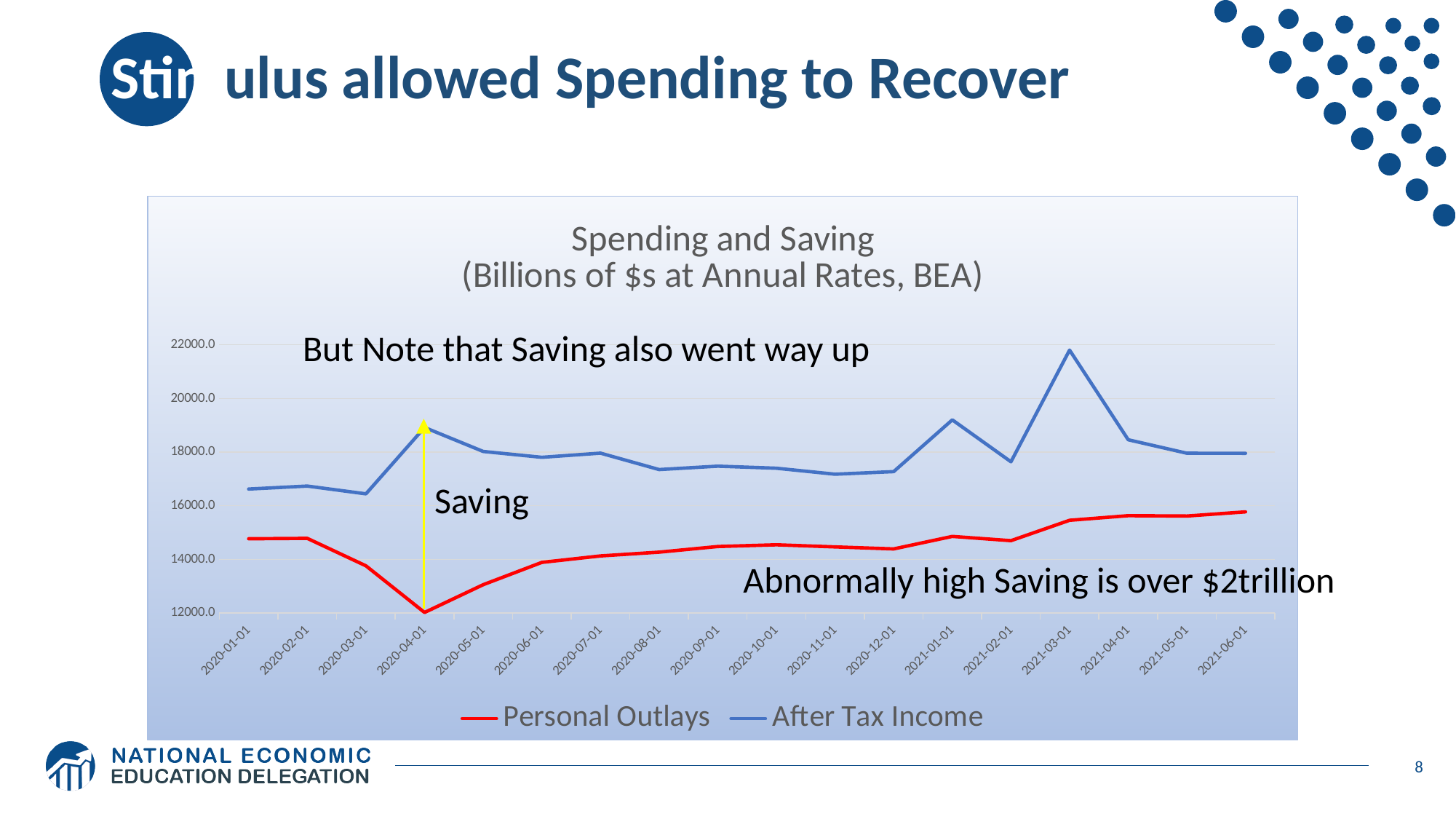
At 2020-04-01, which is larger: After Tax Income or Personal Outlays? After Tax Income Is the value for Personal Outlays at 2021-06-01 greater or less than 14000.0? greater How many dates are plotted along the x axis? 18 Is the value for Personal Outlays at 2020-04-01 greater or less than 14000.0? less How many series does the legend list? 2 Is the value for After Tax Income at 2020-01-01 greater or less than 18000.0? less At which date is Personal Outlays at its lowest? 2020-04-01 Does Personal Outlays rise or fall from 2020-04-01 to 2021-06-01? rise What kind of chart is shown on the slide? line chart What colour is the After Tax Income line? blue At which date does After Tax Income reach its highest value? 2021-03-01